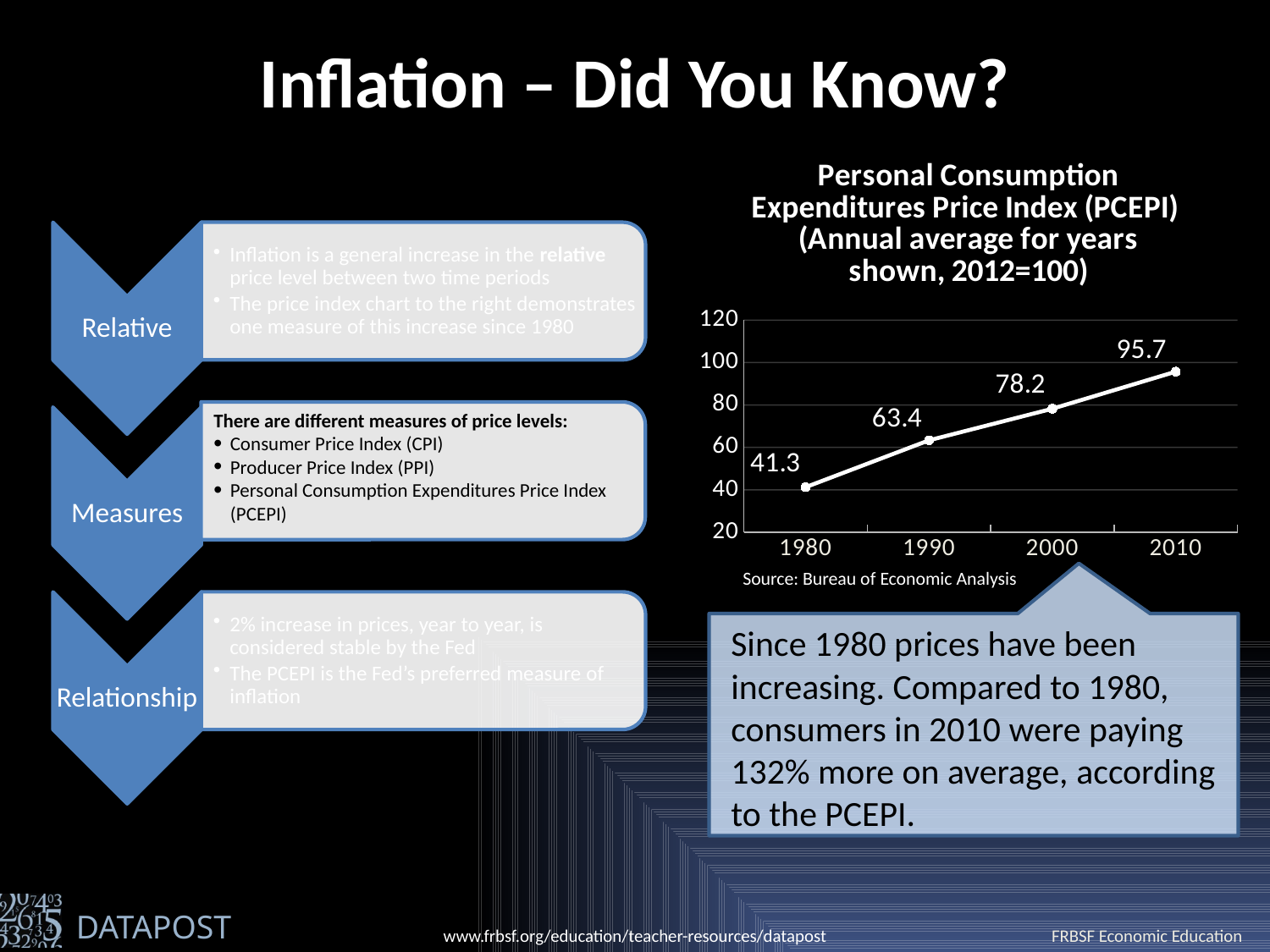
Do the PCEPI values rise or fall from 1980 to 2010? rise Which year has the lowest PCEPI value? 1980 What is the difference between the PCEPI values for 1990 and 1980? 22.1 What is the PCEPI value for 2010? 95.7 Which year has the highest PCEPI value? 2010 What kind of chart is shown on the slide? line chart Which year has a larger PCEPI value, 1990 or 2000? 2000 What is the PCEPI value for 1980? 41.3 Is the PCEPI value for 1990 greater or less than 80? less How many years are plotted on the chart? 4 What is the difference between the PCEPI values for 2010 and 1980? 54.4 What is the PCEPI value for 2000? 78.2